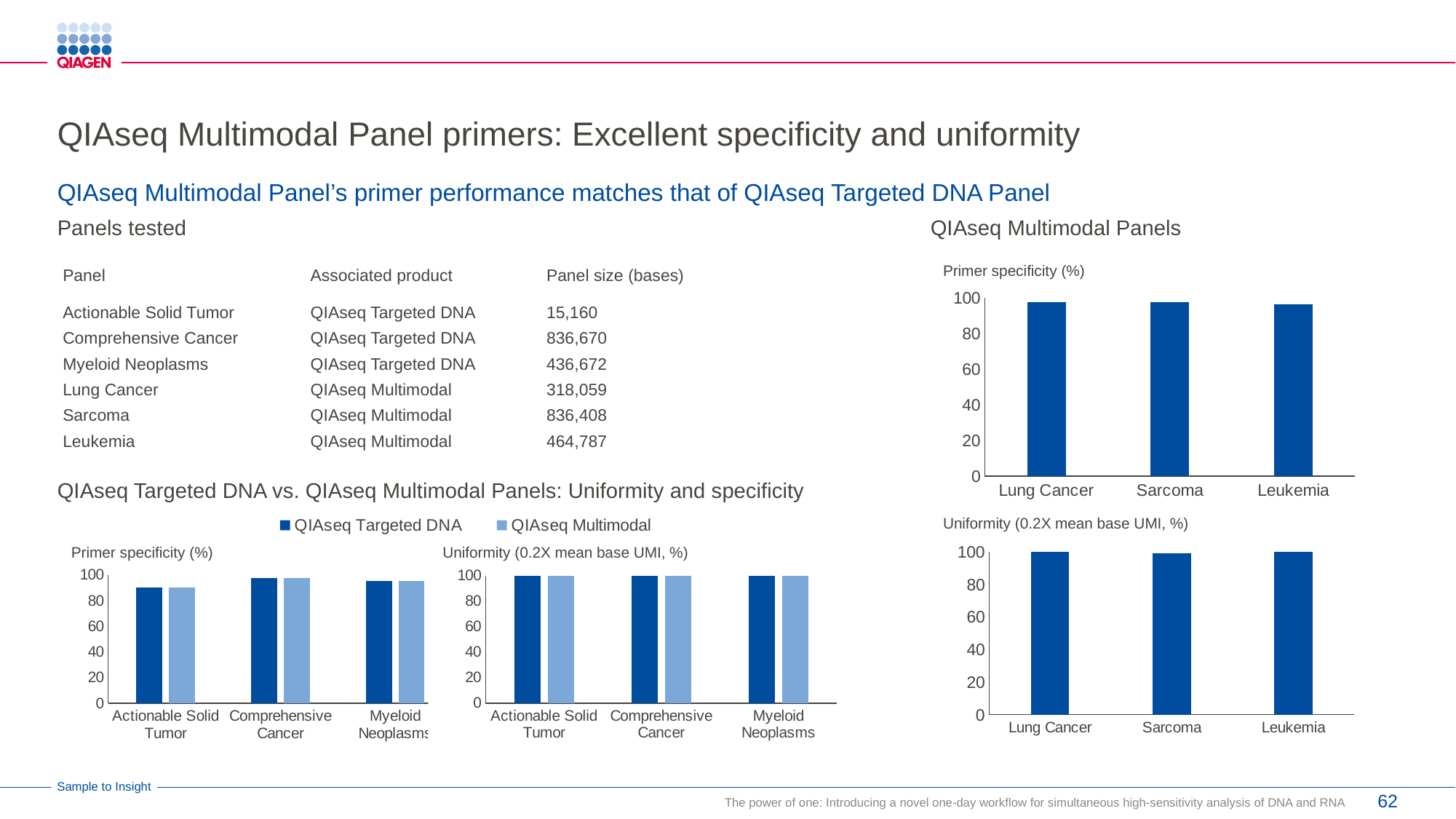
In the top-right 'Primer specificity (%)' chart, is the value for Lung Cancer greater or less than 80? greater In the bottom-middle 'Uniformity (0.2X mean base UMI, %)' chart, is the QIAseq Targeted DNA value for Myeloid Neoplasms greater or less than 80? greater What are the two legend entries for the 'QIAseq Targeted DNA vs. QIAseq Multimodal Panels' charts? QIAseq Targeted DNA, QIAseq Multimodal In the bottom-left 'Primer specificity (%)' chart, which category has the lowest primer specificity? Actionable Solid Tumor How many series does the legend list for the 'QIAseq Targeted DNA vs. QIAseq Multimodal Panels' charts at the bottom left? 2 In the bottom-right 'Uniformity (0.2X mean base UMI, %)' chart, is the value for Sarcoma greater or less than 60? greater What is the maximum value shown on the y axis of the bottom-middle 'Uniformity (0.2X mean base UMI, %)' chart? 100 How many categories are shown on the x axis of the 'Uniformity (0.2X mean base UMI, %)' chart at the bottom right of the slide? 3 What kind of chart is the 'Primer specificity (%)' chart at the top right of the slide? bar chart What are the three categories on the x axis of the top-right 'Primer specificity (%)' chart? Lung Cancer, Sarcoma, Leukemia